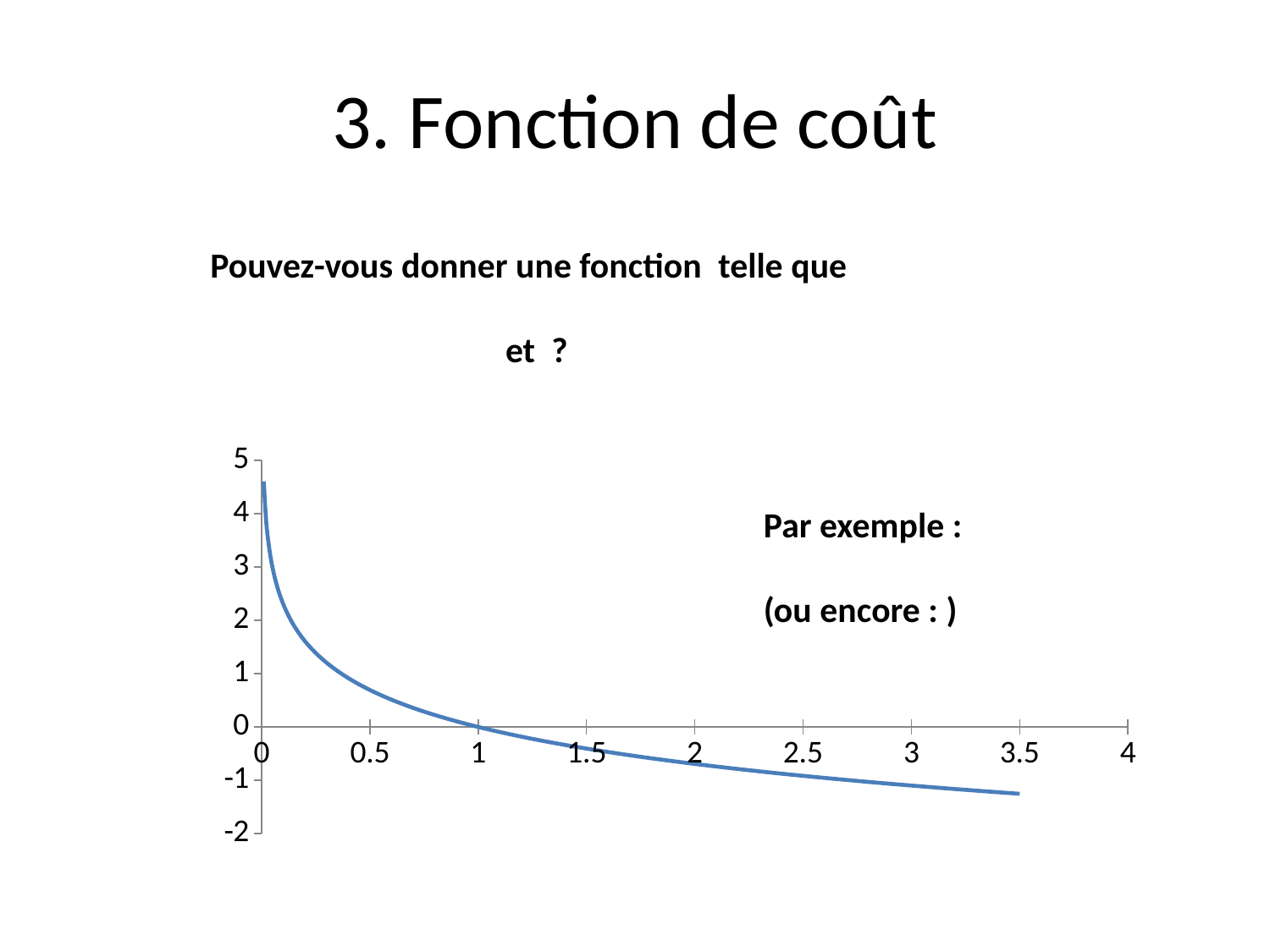
Is the value of the curve at x = 0.5 greater or less than 1? less Do the values of the curve rise or fall as x increases along the horizontal axis? fall At what x value does the curve cross the horizontal axis (y = 0)? 1 Is the value of the curve at x = 3.5 greater or less than -2? greater Which is larger, the value of the curve at x = 0.5 or at x = 2.5? x = 0.5 Is the value of the curve at x = 0.5 greater or less than 0? greater What is the highest tick value shown on the vertical axis? 5 What kind of chart is shown on the slide? line chart How many lines (series) are plotted on the chart? 1